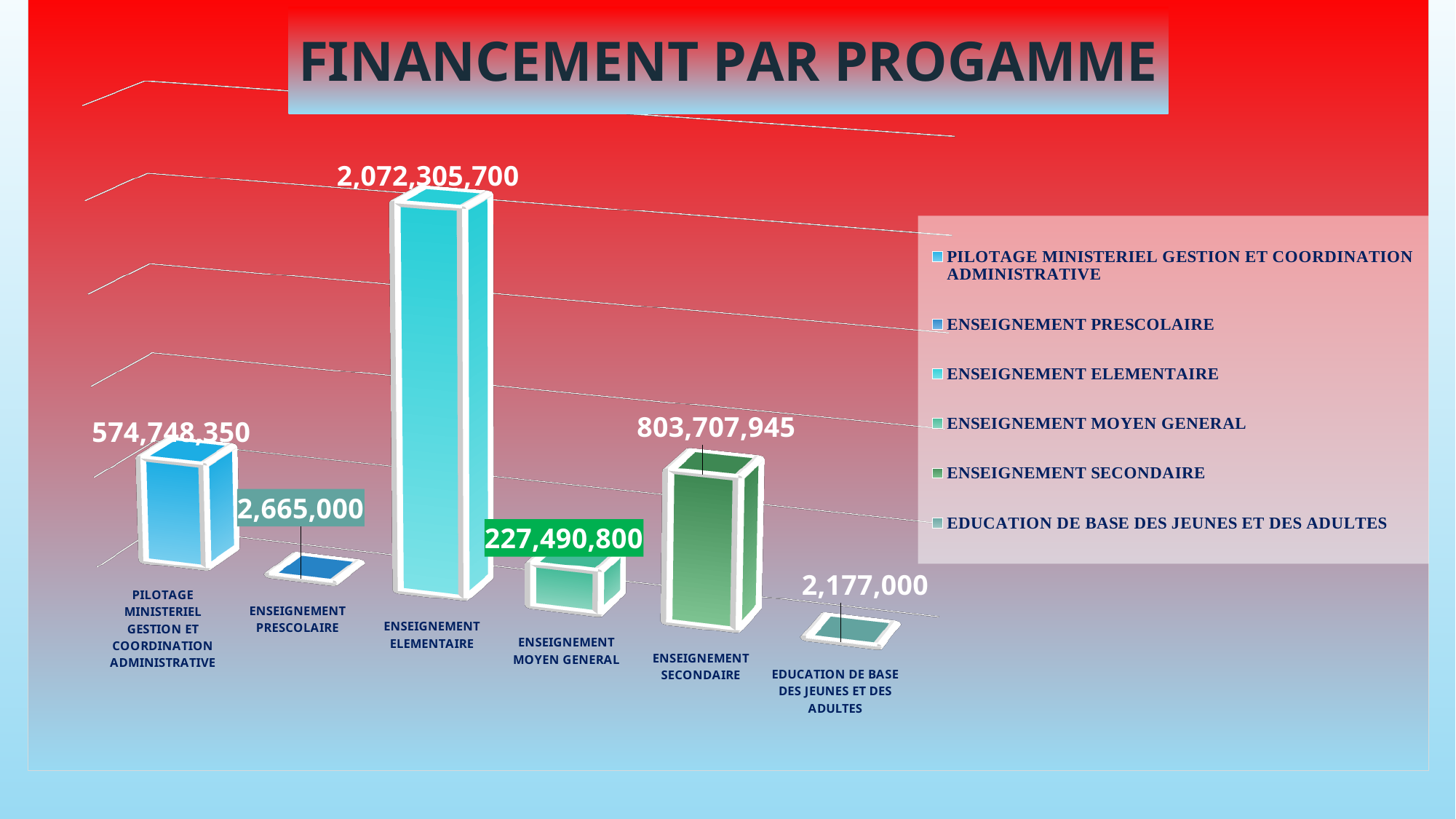
What is the title of the chart? FINANCEMENT PAR PROGAMME Which is larger, the value for PILOTAGE MINISTERIEL GESTION ET COORDINATION ADMINISTRATIVE or the value for ENSEIGNEMENT MOYEN GENERAL? PILOTAGE MINISTERIEL GESTION ET COORDINATION ADMINISTRATIVE What is the difference between the values for ENSEIGNEMENT PRESCOLAIRE and EDUCATION DE BASE DES JEUNES ET DES ADULTES? 488,000 What is the difference between the values for ENSEIGNEMENT SECONDAIRE and PILOTAGE MINISTERIEL GESTION ET COORDINATION ADMINISTRATIVE? 228,959,595 Which programme has the highest financing? ENSEIGNEMENT ELEMENTAIRE What is the value for ENSEIGNEMENT ELEMENTAIRE? 2,072,305,700 What type of chart is shown on the slide? Bar chart Which programme has the lowest financing? EDUCATION DE BASE DES JEUNES ET DES ADULTES What is the value for EDUCATION DE BASE DES JEUNES ET DES ADULTES? 2,177,000 What is the value for ENSEIGNEMENT PRESCOLAIRE? 2,665,000 What is the value for ENSEIGNEMENT SECONDAIRE? 803,707,945 How many programmes are shown in the chart? 6